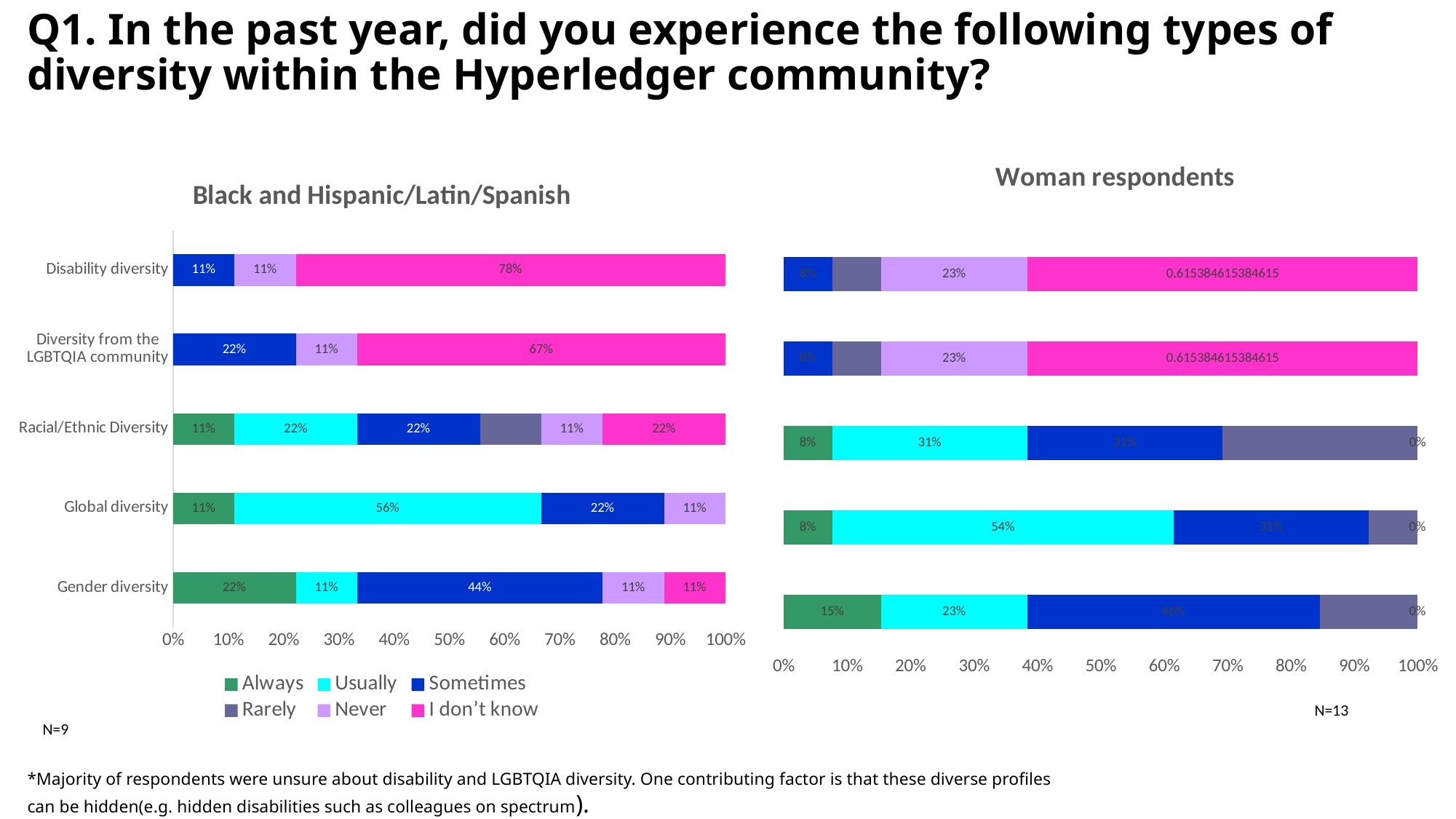
In the Black and Hispanic/Latin/Spanish chart, which category has the highest "I don't know" share? Disability diversity How many diversity categories are shown in the Black and Hispanic/Latin/Spanish chart? 5 What type of chart is used on this slide? Stacked bar chart In the Black and Hispanic/Latin/Spanish chart, which has the larger "Usually" value: Global diversity or Racial/Ethnic Diversity? Global diversity In the Black and Hispanic/Latin/Spanish chart, what is the difference between the "I don't know" values for Disability diversity and Diversity from the LGBTQIA community? 11 percentage points What is the sample size (N) shown for the Woman respondents chart? N=13 In the Black and Hispanic/Latin/Spanish chart, what is the "Sometimes" value for Gender diversity? 44% In the Black and Hispanic/Latin/Spanish chart, what is the "Usually" value for Global diversity? 56% In the Woman respondents chart, what is the "Usually" value in the fourth bar from the top? 54% In the Black and Hispanic/Latin/Spanish chart, what percentage of respondents answered "I don't know" for Disability diversity? 78% In the Black and Hispanic/Latin/Spanish chart, what is the "Always" value for Gender diversity? 22% How many response options does the legend list? 6